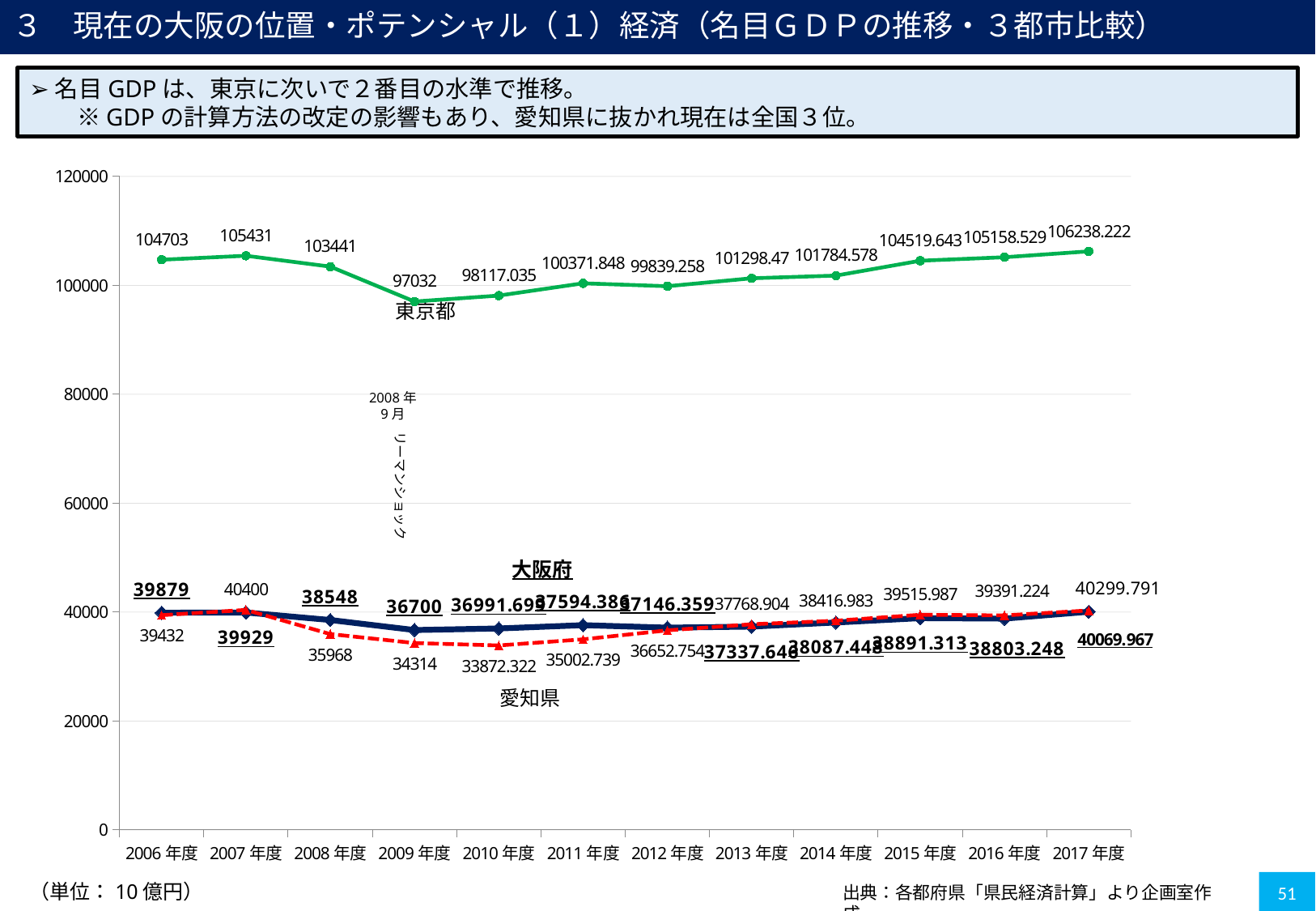
What is the value for 大阪府 in 2009年度? 36700 What event is annotated on the chart at 2008年9月? リーマンショック Is the value for 東京都 in 2009年度 greater or less than 100000? less What is the difference between the 東京都 values for 2007年度 and 2006年度? 728 In which fiscal year is the value for 東京都 highest? 2017年度 How many fiscal years are plotted along the x axis? 12 What is the value for 東京都 in 2017年度? 106238.222 Which has the larger value in 2017年度, 大阪府 or 愛知県? 愛知県 What kind of chart is shown on the slide? line chart What is the value for 大阪府 in 2006年度? 39879 What is the value for 愛知県 in 2010年度? 33872.322 In which fiscal year is the value for 東京都 lowest? 2009年度